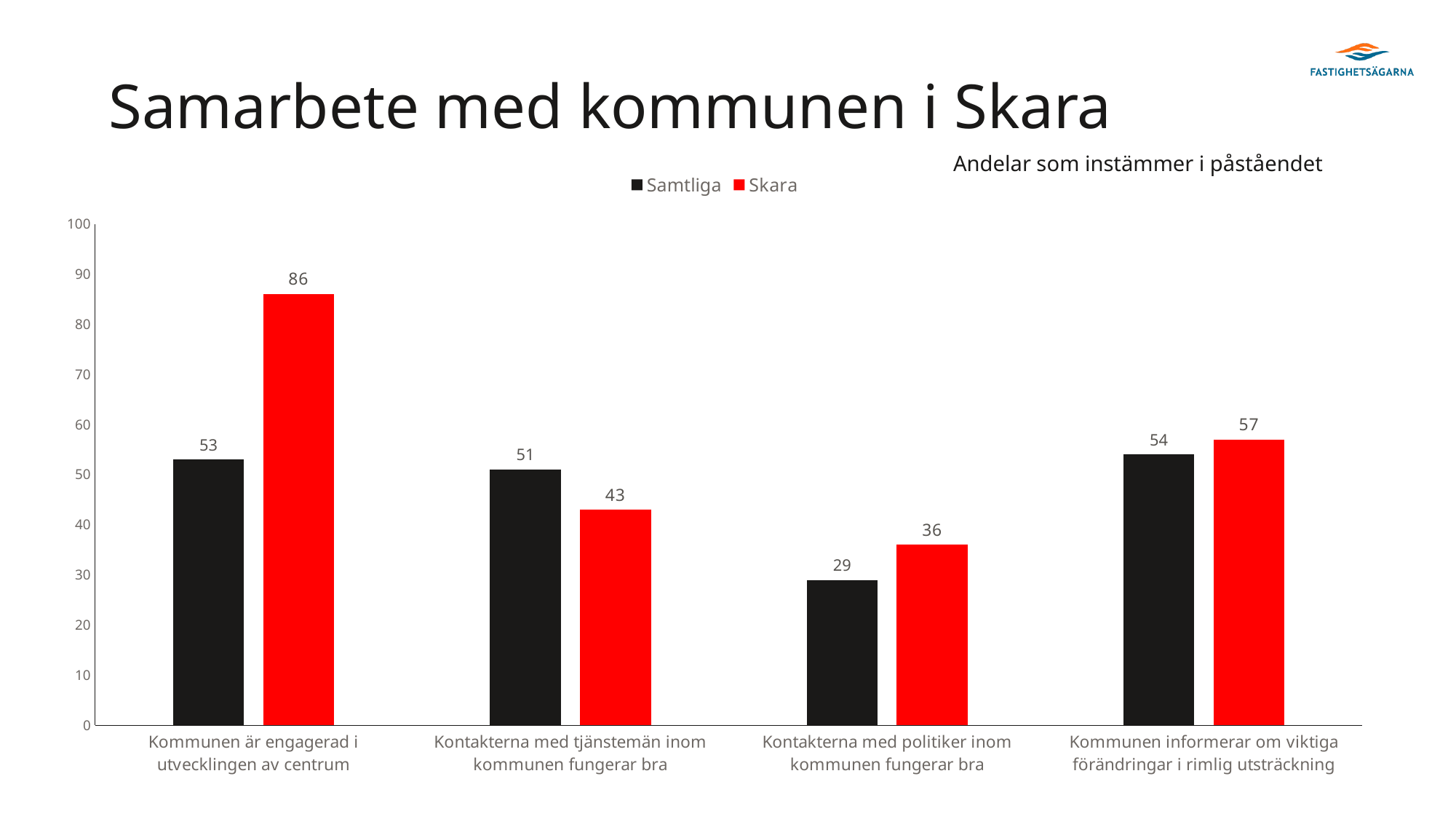
What is the difference between the Skara and Samtliga values for "Kommunen är engagerad i utvecklingen av centrum"? 33 For "Kontakterna med tjänstemän inom kommunen fungerar bra", which series has the larger value, Samtliga or Skara? Samtliga How many series does the legend list? 2 Which colour represents the Skara series in the legend? red Which category has the highest Skara value? Kommunen är engagerad i utvecklingen av centrum Is the Skara value for "Kontakterna med politiker inom kommunen fungerar bra" greater or less than 40? less Which category has the lowest Samtliga value? Kontakterna med politiker inom kommunen fungerar bra What is the Skara value for "Kommunen är engagerad i utvecklingen av centrum"? 86 What is the Samtliga value for "Kontakterna med politiker inom kommunen fungerar bra"? 29 How many categories are shown on the x axis? 4 What kind of chart is shown on the slide? bar chart What is the Skara value for "Kommunen informerar om viktiga förändringar i rimlig utsträckning"? 57